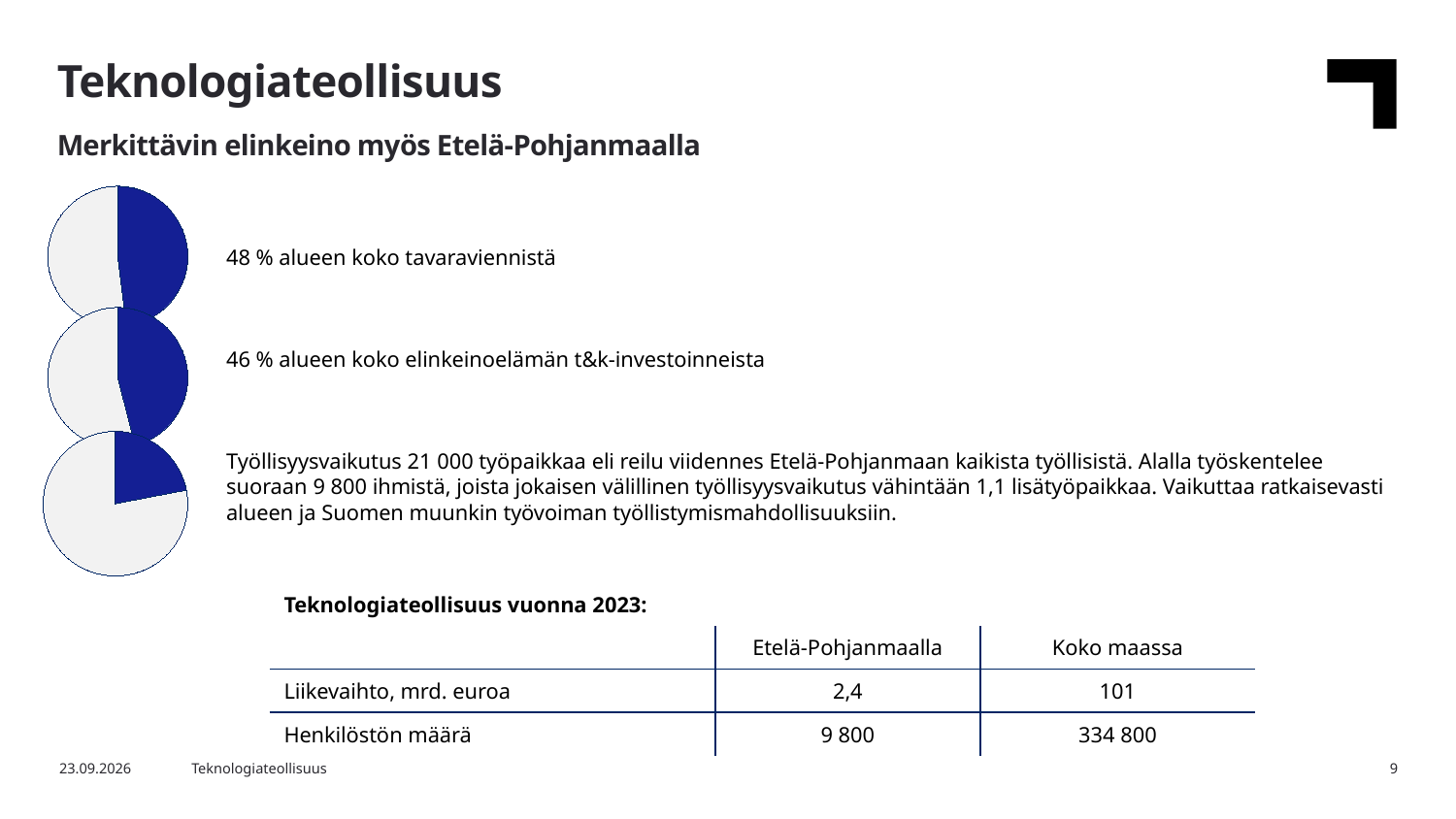
In the middle pie chart, what share of the region's business R&D investments (t&k-investoinnit) does the highlighted slice represent? 46 % How many pie charts are on the slide? 3 What kind of charts are shown on the left side of the slide? Pie charts Is the highlighted slice in the bottom pie chart greater or less than 50 % of the pie? less Which highlighted slice is larger: the one in the top pie chart (goods exports) or the one in the middle pie chart (R&D investments)? Top pie chart (goods exports) Which pie chart has the largest highlighted slice: the top, middle or bottom one? Top Which pie chart has the smallest highlighted slice: the top, middle or bottom one? Bottom What colour are the highlighted slices in the pie charts? Dark blue In the top pie chart, what share of the region's total goods exports (tavaravienti) does the highlighted slice represent? 48 % What does the highlighted slice in the top pie chart represent? Share of the region's total goods exports (48 % alueen koko tavaraviennistä) By how many percentage points does the highlighted share in the top pie chart (48 %) exceed the highlighted share in the middle pie chart (46 %)? 2 percentage points